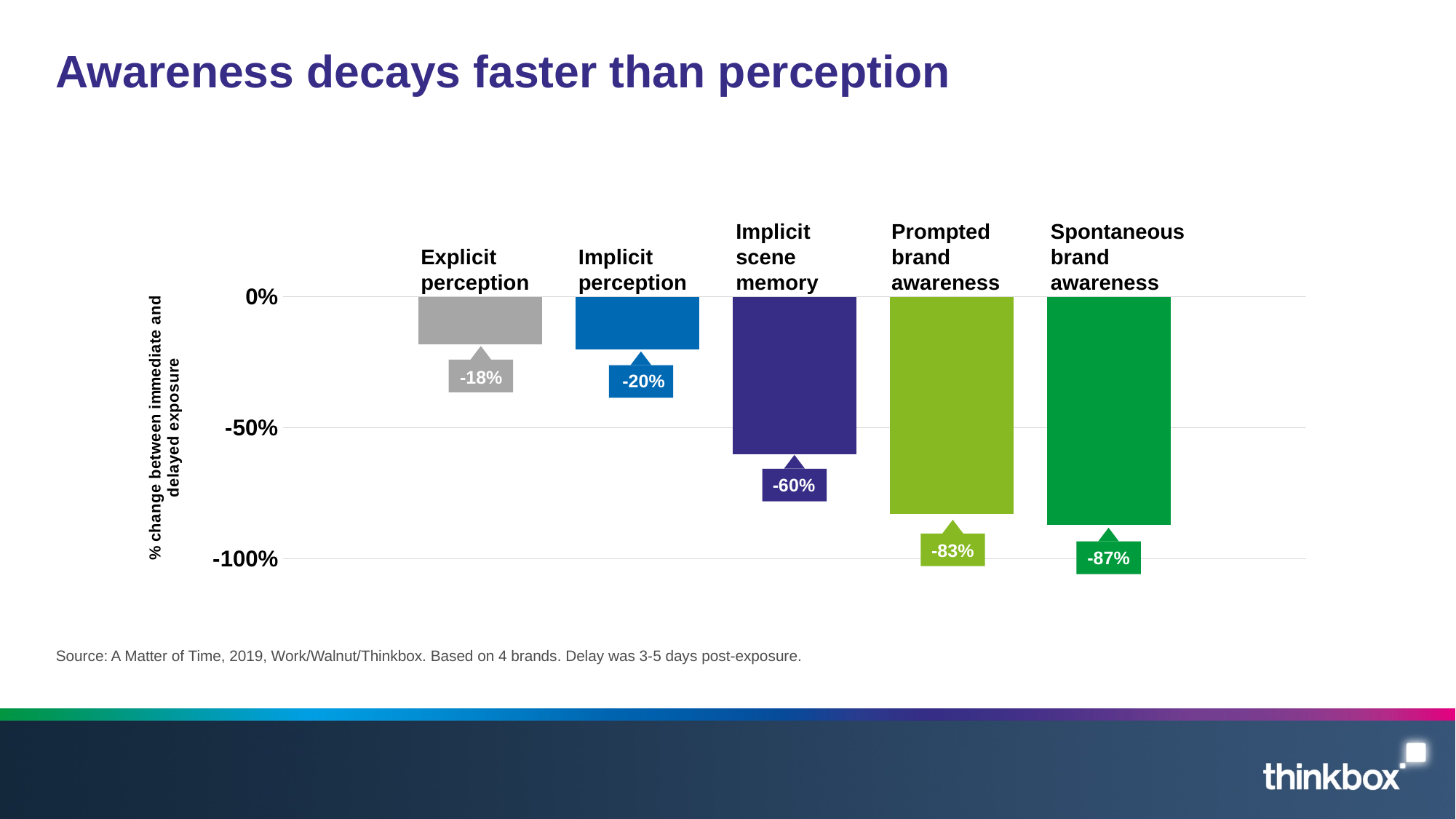
Which category shows the smallest decline (value closest to 0%)? Explicit perception How many categories are shown in the chart? 5 What is the value for Explicit perception? -18% Which declined more, Prompted brand awareness or Implicit scene memory? Prompted brand awareness What is the difference between the values for Implicit perception and Explicit perception? 2 percentage points What kind of chart is shown on the slide? Bar chart What is the difference between the values for Spontaneous brand awareness and Implicit scene memory? 27 percentage points What is the value for Spontaneous brand awareness? -87% What is the value for Implicit scene memory? -60% What is the label of the vertical axis? % change between immediate and delayed exposure Which category shows the largest decline (most negative value)? Spontaneous brand awareness What is the value for Prompted brand awareness? -83%